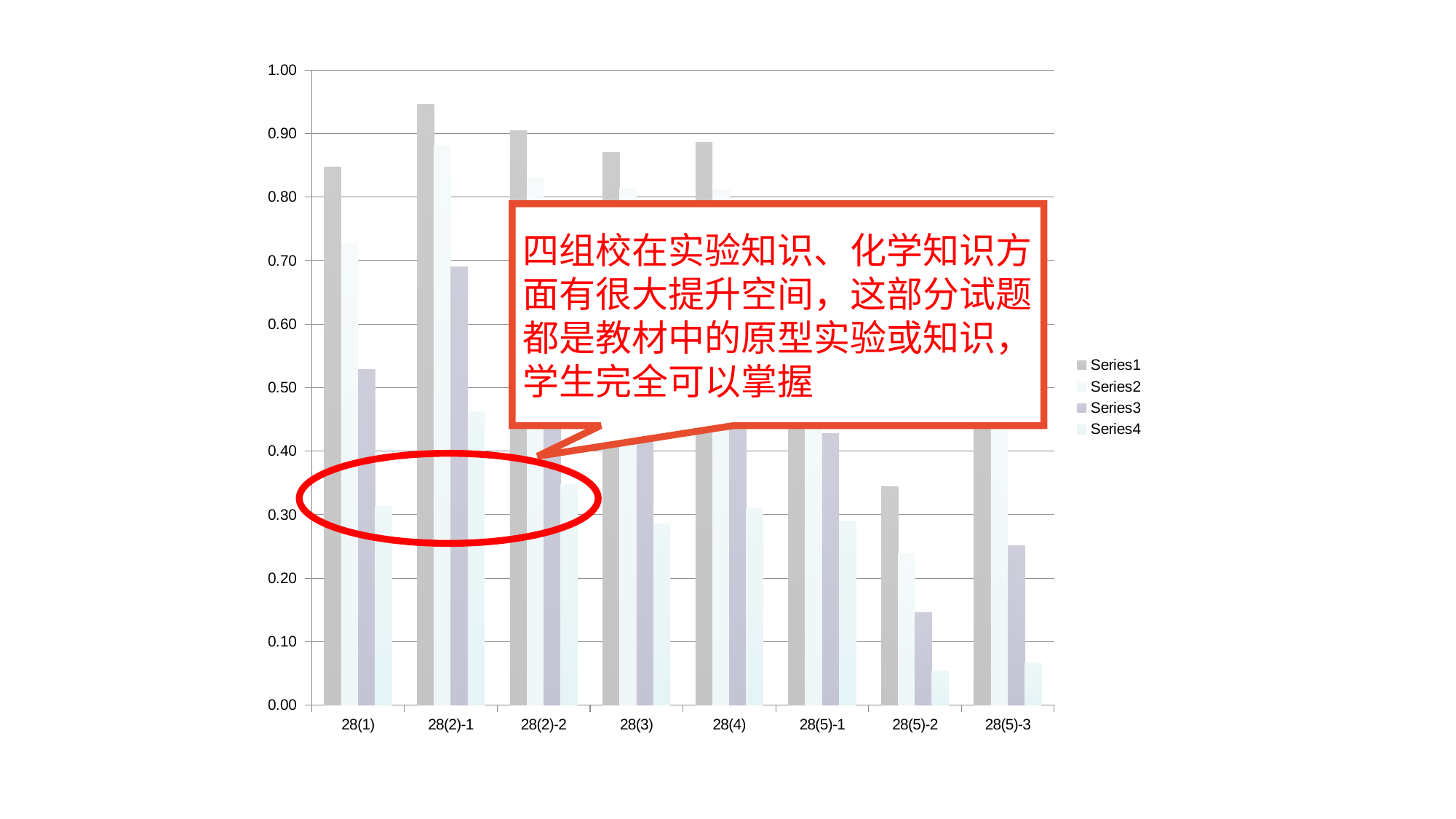
What kind of chart is shown on the slide? bar chart How many series does the legend list? 4 Is the Series4 value for 28(5)-2 greater or less than 0.10? less What is the name of the first series listed in the legend? Series1 How many categories are shown on the x axis? 8 Which is larger, the Series1 value for 28(1) or the Series1 value for 28(2)-1? 28(2)-1 Which category has the highest Series1 value? 28(2)-1 Is the Series3 value for 28(1) greater or less than 0.50? greater Is the Series2 value for 28(5)-2 greater or less than 0.30? less Which category has the lowest Series1 value? 28(5)-2 Which category has the lowest Series3 value? 28(5)-2